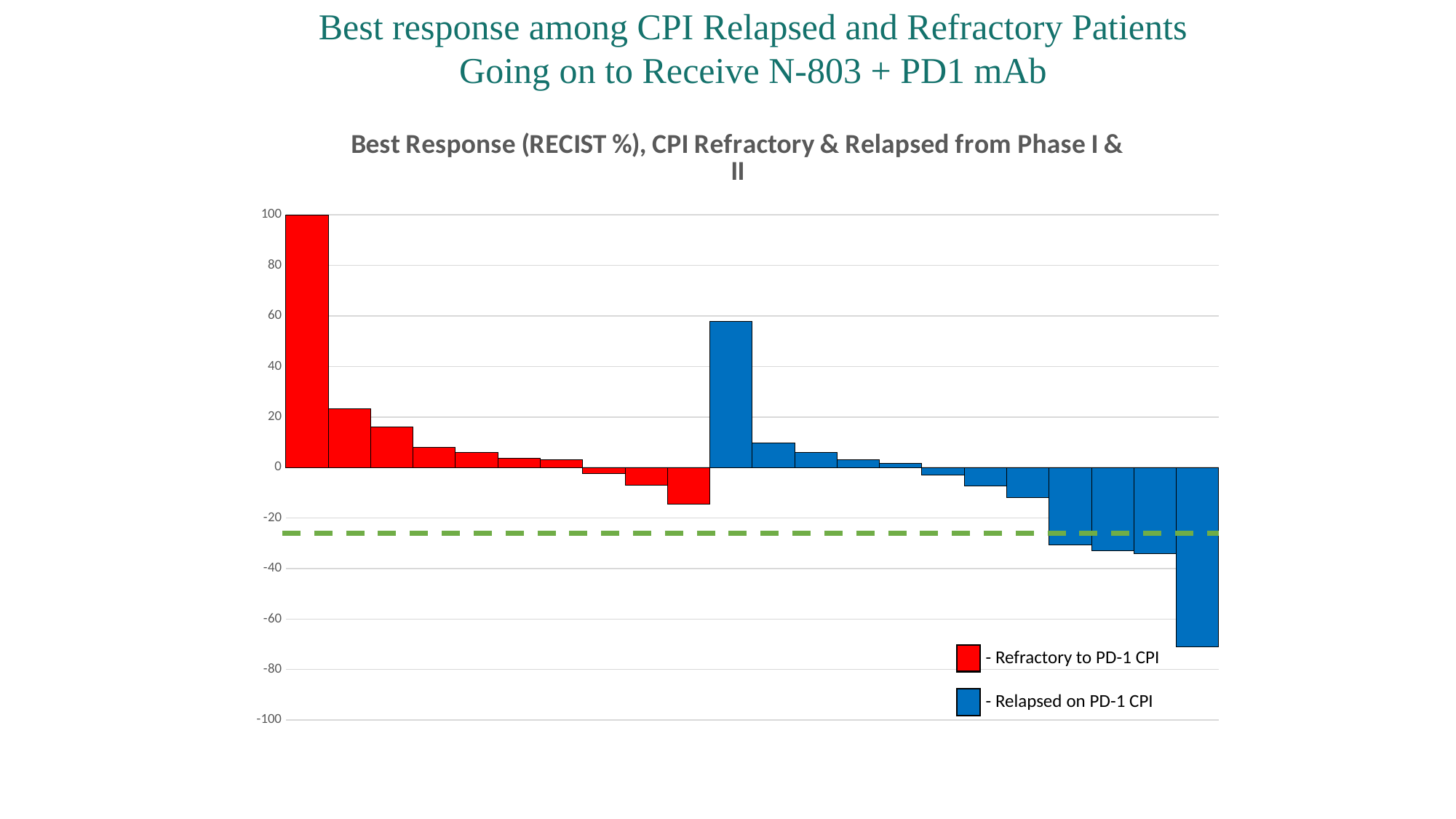
Is the value of the lowest red bar greater or less than -20? greater How many red (Refractory to PD-1 CPI) bars are plotted? 10 Which series contains the bar with the lowest value, Refractory to PD-1 CPI or Relapsed on PD-1 CPI? Relapsed on PD-1 CPI Is the value of the tallest blue bar greater or less than 40? greater Which colour represents patients Refractory to PD-1 CPI? Red Is the value of the tallest red bar greater or less than 80? greater What is the title of the chart? Best Response (RECIST %), CPI Refractory & Relapsed from Phase I & II How many series does the legend list? 2 Which series contains the bar with the highest value, Refractory to PD-1 CPI or Relapsed on PD-1 CPI? Refractory to PD-1 CPI How many blue (Relapsed on PD-1 CPI) bars are plotted? 12 What kind of chart is shown on the slide? Bar chart